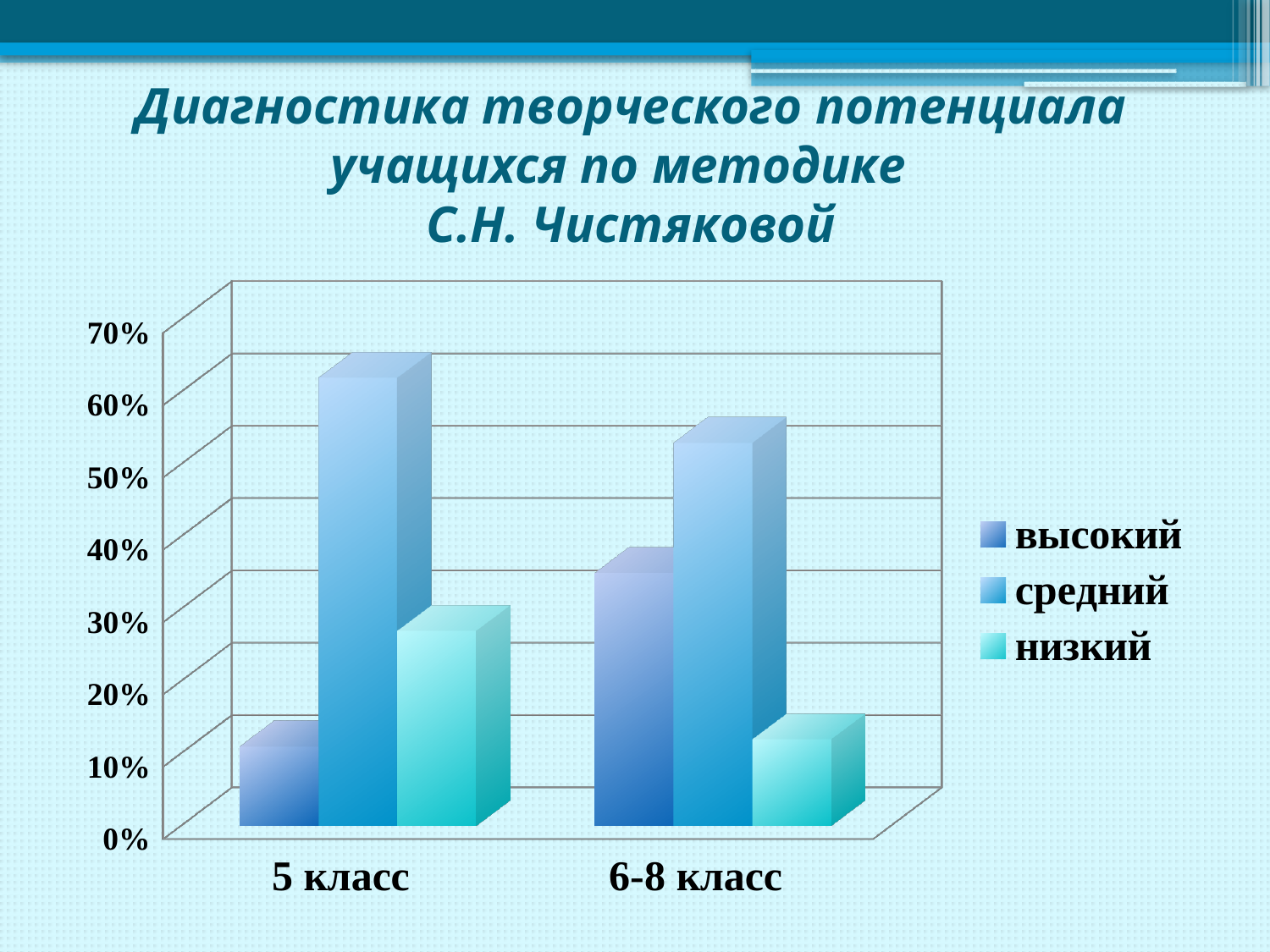
Which series has the highest value for 5 класс? средний What kind of chart is shown on the slide? bar chart What are the three legend entries of the chart? высокий, средний, низкий How many series does the legend list? 3 How many categories are shown on the x axis? 2 Which series has the lowest value for 5 класс? высокий Is the value of низкий for 6-8 класс greater or less than 20%? less Which series has the lowest value for 6-8 класс? низкий Is the value of средний for 5 класс greater or less than 50%? greater Which category has the larger value for высокий: 5 класс or 6-8 класс? 6-8 класс Is the value of высокий for 6-8 класс greater or less than 20%? greater Which category has the larger value for низкий: 5 класс or 6-8 класс? 5 класс